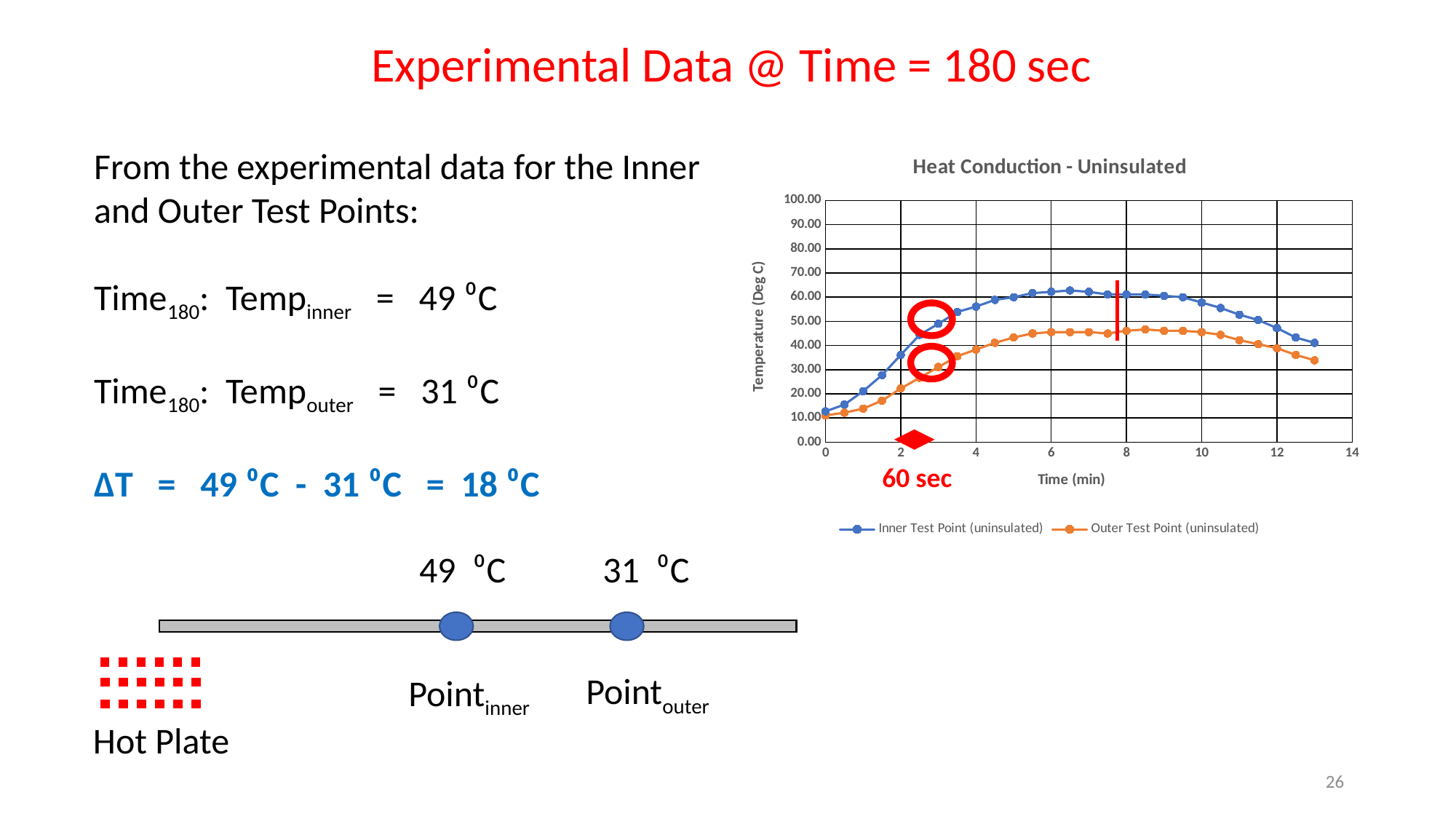
At 8 minutes, which series has the higher temperature, Inner Test Point or Outer Test Point? Inner Test Point (uninsulated) Does the Inner Test Point temperature rise or fall between 0 and 5 minutes? rise How many series does the chart legend list? 2 Is the Outer Test Point temperature at 6 minutes greater or less than 50.00? less What is the title of the chart? Heat Conduction - Uninsulated What are the two series named in the chart legend? Inner Test Point (uninsulated) and Outer Test Point (uninsulated) According to the slide, what is the inner test point temperature at time 180 sec? 49 °C What is the difference between the inner and outer test point temperatures at time 180 sec? 18 °C What type of chart is shown on the slide? line chart Is the Inner Test Point temperature at 6 minutes greater or less than 50.00? greater According to the slide, what is the outer test point temperature at time 180 sec? 31 °C Does the Outer Test Point temperature rise or fall between 9 and 13 minutes? fall